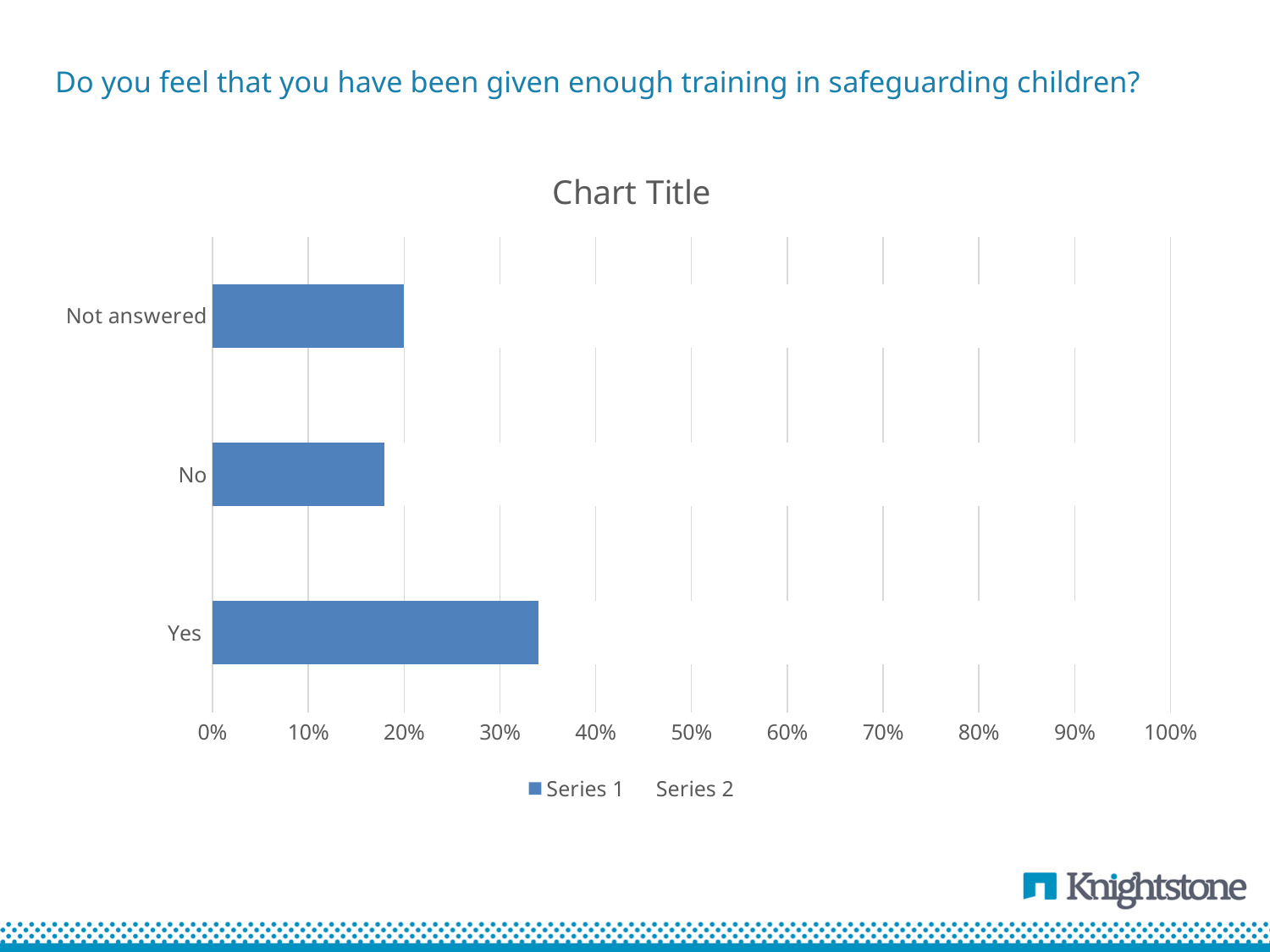
How many series does the legend list? 2 What is the value for Not answered? 20% What is the title of the chart? Chart Title What are the two entries listed in the legend? Series 1 and Series 2 Is the value for Yes greater or less than 30%? greater Is the value for Yes greater or less than 40%? less How many categories are shown on the chart? 3 Is the value for No greater or less than 20%? less Which category has the lowest value? No Which category has the highest value? Yes What kind of chart is shown on the slide? bar chart Which is larger, the value for No or the value for Not answered? Not answered